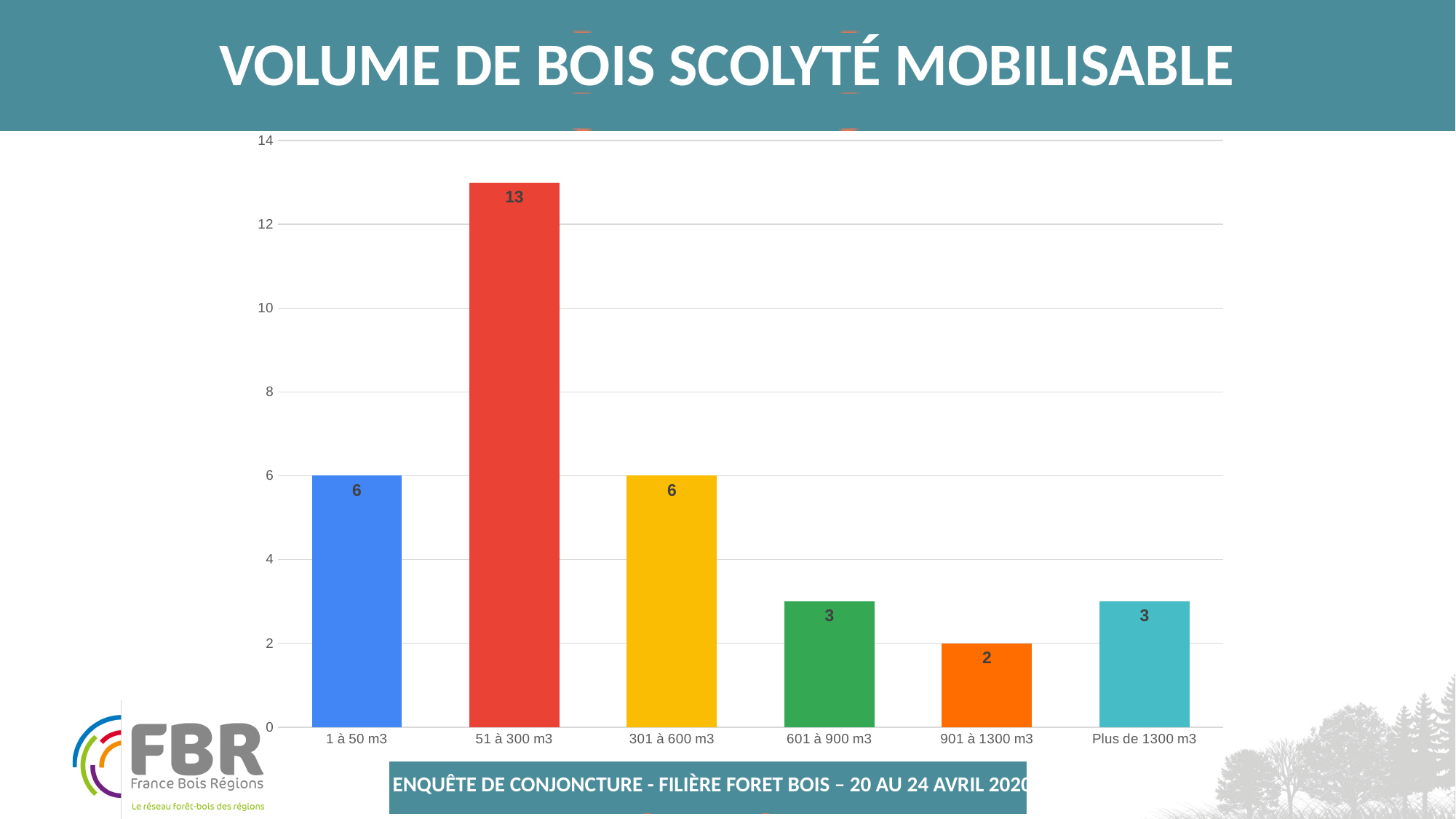
How many categories are shown on the x axis? 6 What is the value for the '901 à 1300 m3' category? 2 What is the title of the slide? VOLUME DE BOIS SCOLYTÉ MOBILISABLE Which category has the lowest value? 901 à 1300 m3 What is the value for the '51 à 300 m3' category? 13 What colour is the bar for '51 à 300 m3'? red Which is larger, the value for '601 à 900 m3' or the value for '901 à 1300 m3'? 601 à 900 m3 What is the value for the 'Plus de 1300 m3' category? 3 What kind of chart is shown on the slide? bar chart Which category has the highest value? 51 à 300 m3 Is the value for '51 à 300 m3' greater or less than 12? greater What is the difference between the values for '51 à 300 m3' and '1 à 50 m3'? 7